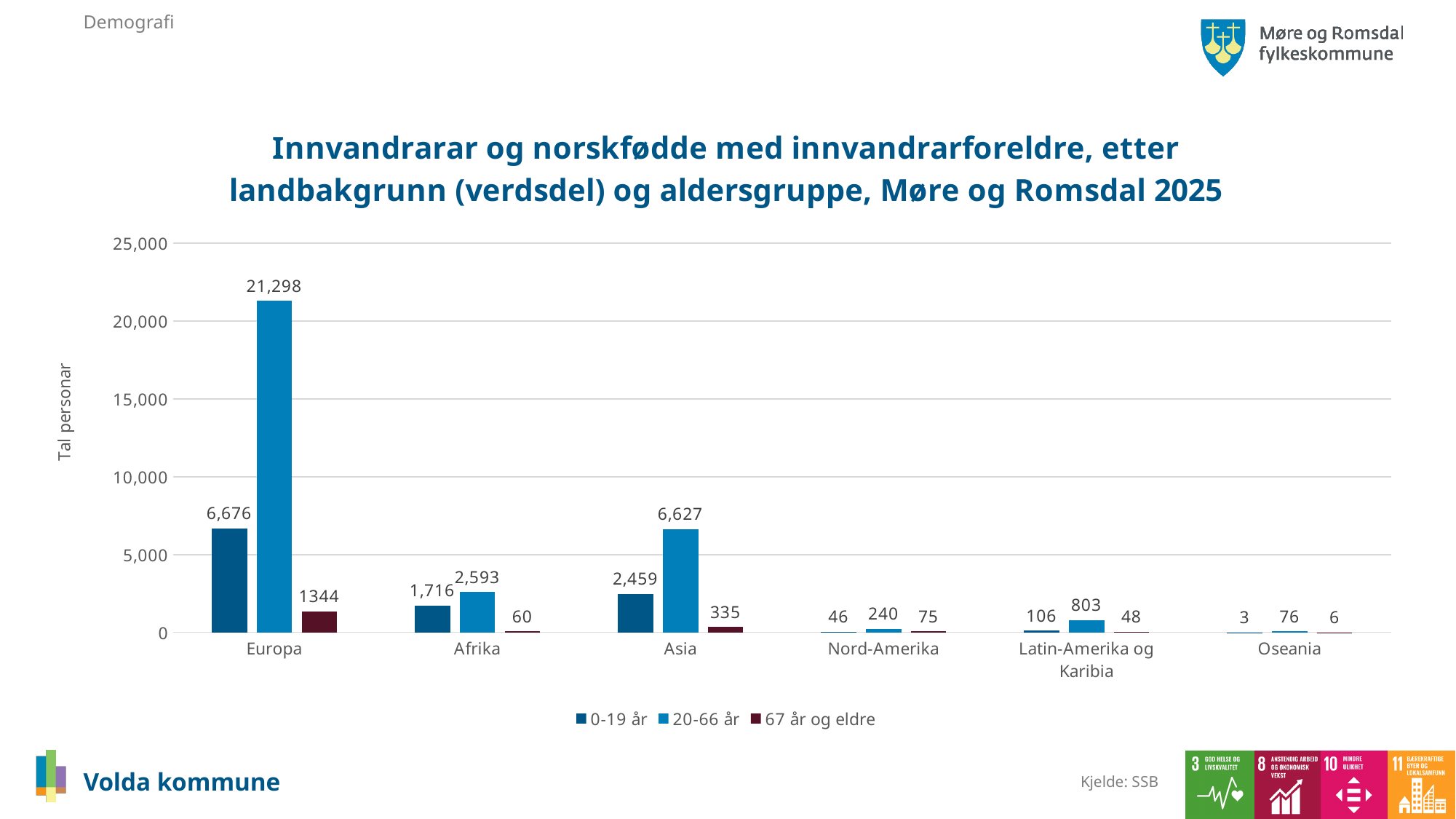
Is the 20-66 år value for Europa greater or less than 20,000? greater What is the value for the 67 år og eldre series for Asia? 335 What is the value for the 0-19 år series for Latin-Amerika og Karibia? 106 What is the value for the 20-66 år series for Europa? 21,298 What is the difference between the 20-66 år values for Asia and Afrika? 4,034 Which category has the lowest value in the 0-19 år series? Oseania What kind of chart is shown on the slide? Bar chart How many series does the legend list? 3 How many categories are shown on the x axis? 6 Which is larger: the 0-19 år value for Afrika or the 0-19 år value for Asia? Asia What is the difference between the 20-66 år and 0-19 år values for Europa? 14,622 Which category has the highest value in the 20-66 år series? Europa